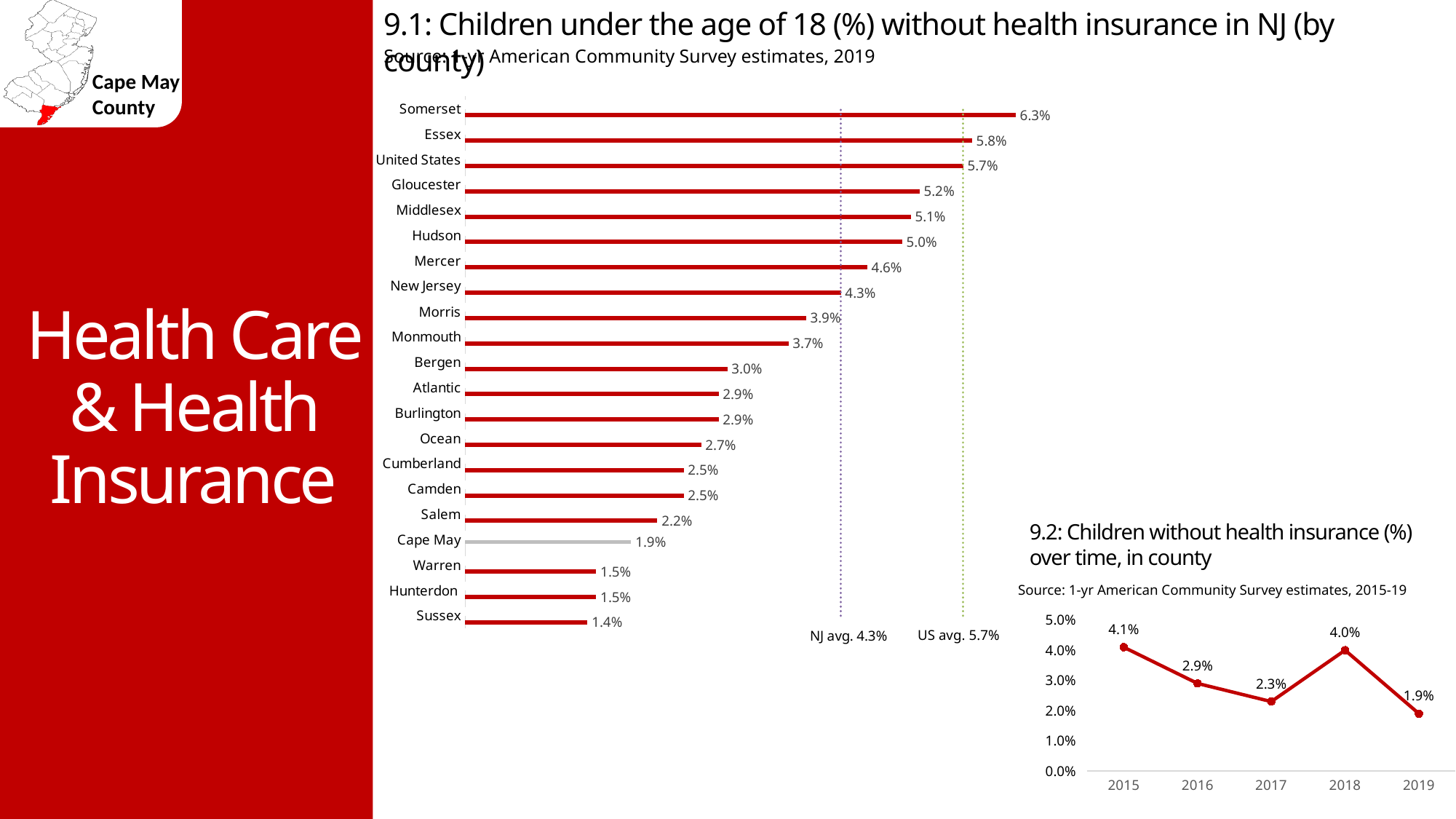
In chart 9.2, what is the difference between the values for 2015 and 2019? 2.2% In chart 9.1 (children without health insurance by county), what is the value for Cape May? 1.9% What kind of chart is chart 9.2 (children without health insurance over time)? line chart In chart 9.2, which year has the lowest value? 2019 In chart 9.1, what is the value for Hudson? 5.0% In chart 9.1, which category has the highest value? Somerset In chart 9.1, what is the difference between the values for Somerset and Cape May? 4.4% In chart 9.1, which is larger, the value for Mercer or the value for Morris? Mercer In chart 9.1, how many categories (bars) are shown? 21 In chart 9.1, which category has the lowest value? Sussex In chart 9.2, what is the value for 2018? 4.0% In chart 9.1, what is the NJ average shown by the dotted reference line? 4.3%